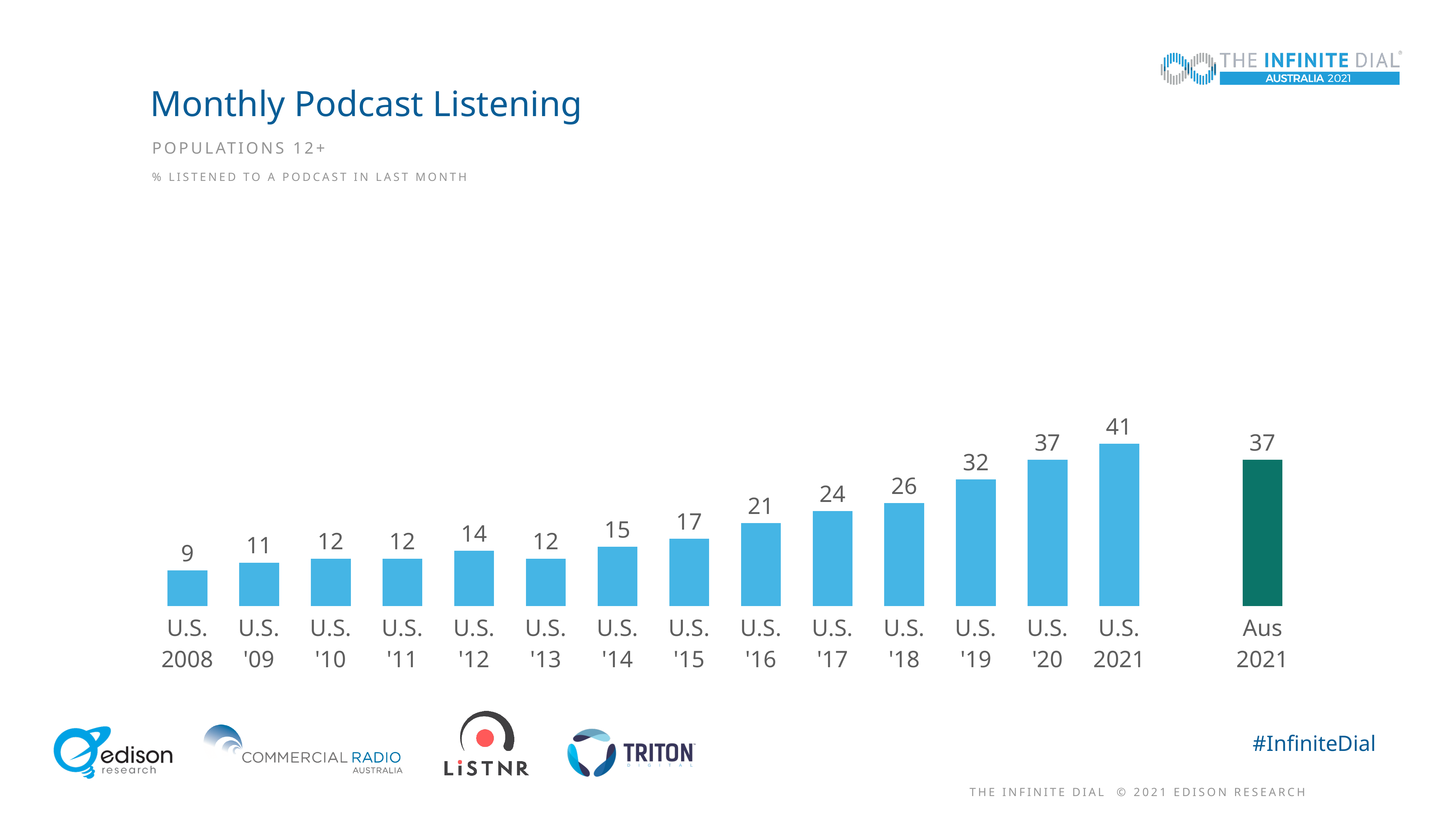
How many bars are shown in the chart? 15 What is the value for U.S. 2021? 41 What is the value for U.S. '16? 21 Which is larger, the value for U.S. '17 or the value for U.S. '15? U.S. '17 What is the difference between the values for U.S. 2021 and Aus 2021? 4 Which category has the lowest value? U.S. 2008 What is the value for U.S. 2008? 9 What is the value for Aus 2021? 37 What kind of chart is shown on the slide? Bar chart What is the difference between the values for U.S. '19 and U.S. '18? 6 Which is larger, the value for U.S. '20 or the value for Aus 2021? They are equal (37) Which category has the highest value? U.S. 2021